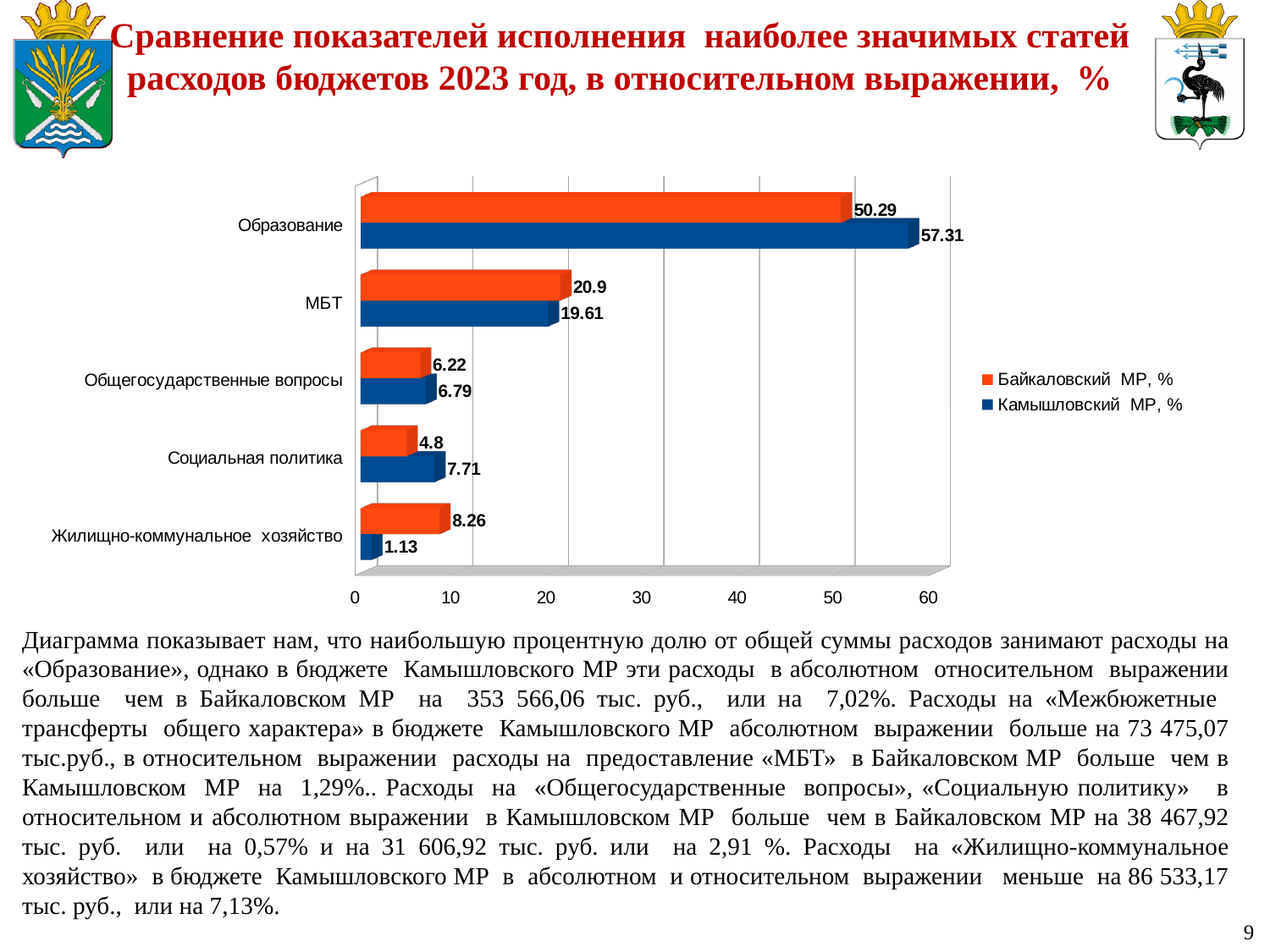
Is the value for Образование in the Камышловский МР, % series greater or less than 50? greater What kind of chart is shown on the slide? Bar chart How many series does the legend list? 2 What is the value for Социальная политика in the Байкаловский МР, % series? 4.8 Which category has the highest value in the Байкаловский МР, % series? Образование What is the difference between the Камышловский МР, % and Байкаловский МР, % values for Образование? 7.02 Which category has the lowest value in the Камышловский МР, % series? Жилищно-коммунальное хозяйство What is the value for Образование in the Байкаловский МР, % series? 50.29 What is the value for Жилищно-коммунальное хозяйство in the Камышловский МР, % series? 1.13 For МБТ, which series has the larger value: Байкаловский МР, % or Камышловский МР, %? Байкаловский МР, % What is the value for Образование in the Камышловский МР, % series? 57.31 How many categories are shown on the chart? 5